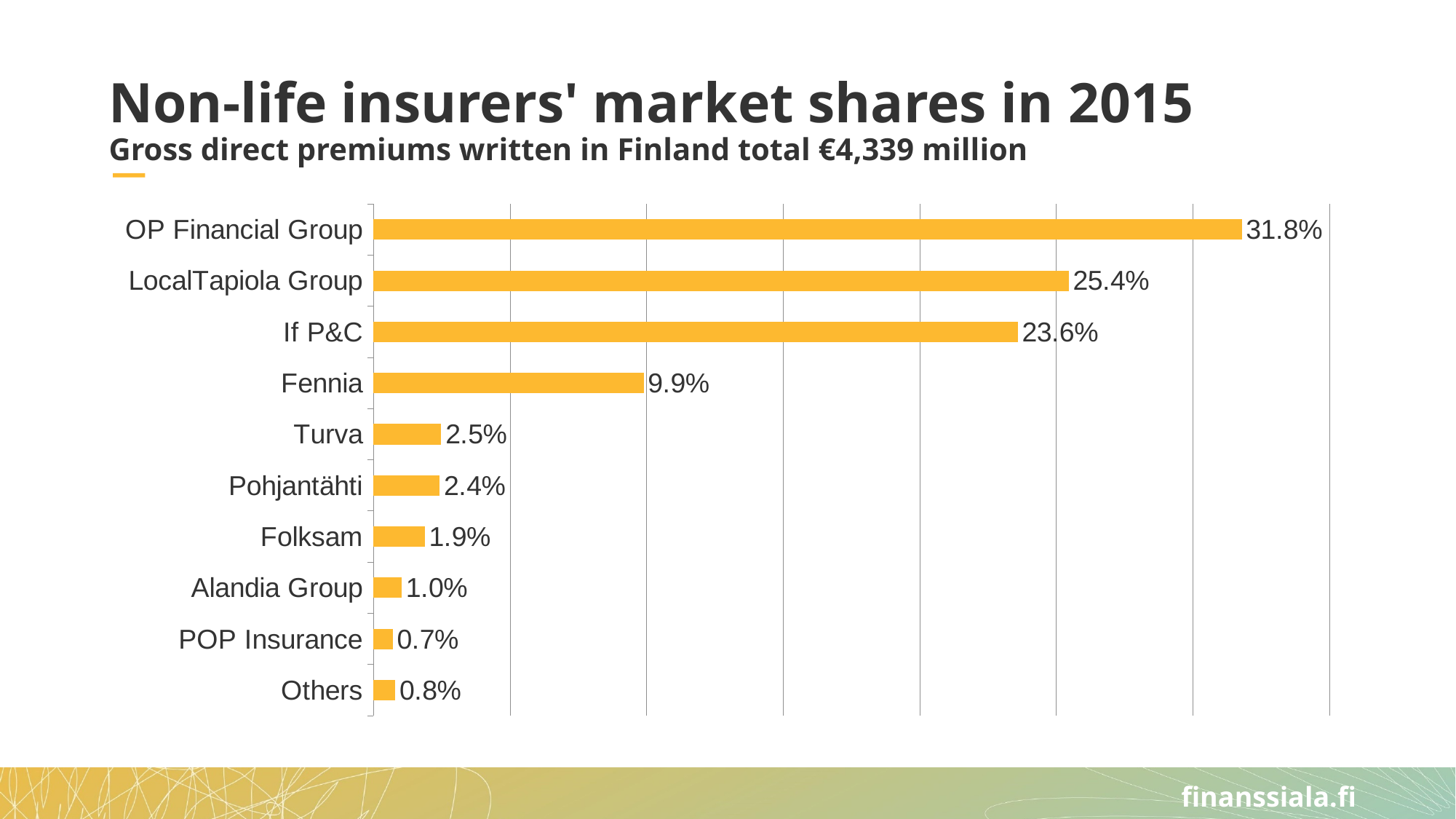
What is the title of the chart on the slide? Non-life insurers' market shares in 2015 What kind of chart is shown on the slide? Bar chart Which insurer has the highest market share? OP Financial Group What is the difference in market share between OP Financial Group and Fennia? 21.9% What is the market share of Alandia Group? 1.0% What is the market share of Fennia? 9.9% What is the market share of OP Financial Group? 31.8% What is the difference in market share between LocalTapiola Group and If P&C? 1.8% Which has a larger market share, Turva or Folksam? Turva Which has a larger market share, If P&C or LocalTapiola Group? LocalTapiola Group How many categories are shown in the chart? 10 Which category has the lowest market share? POP Insurance